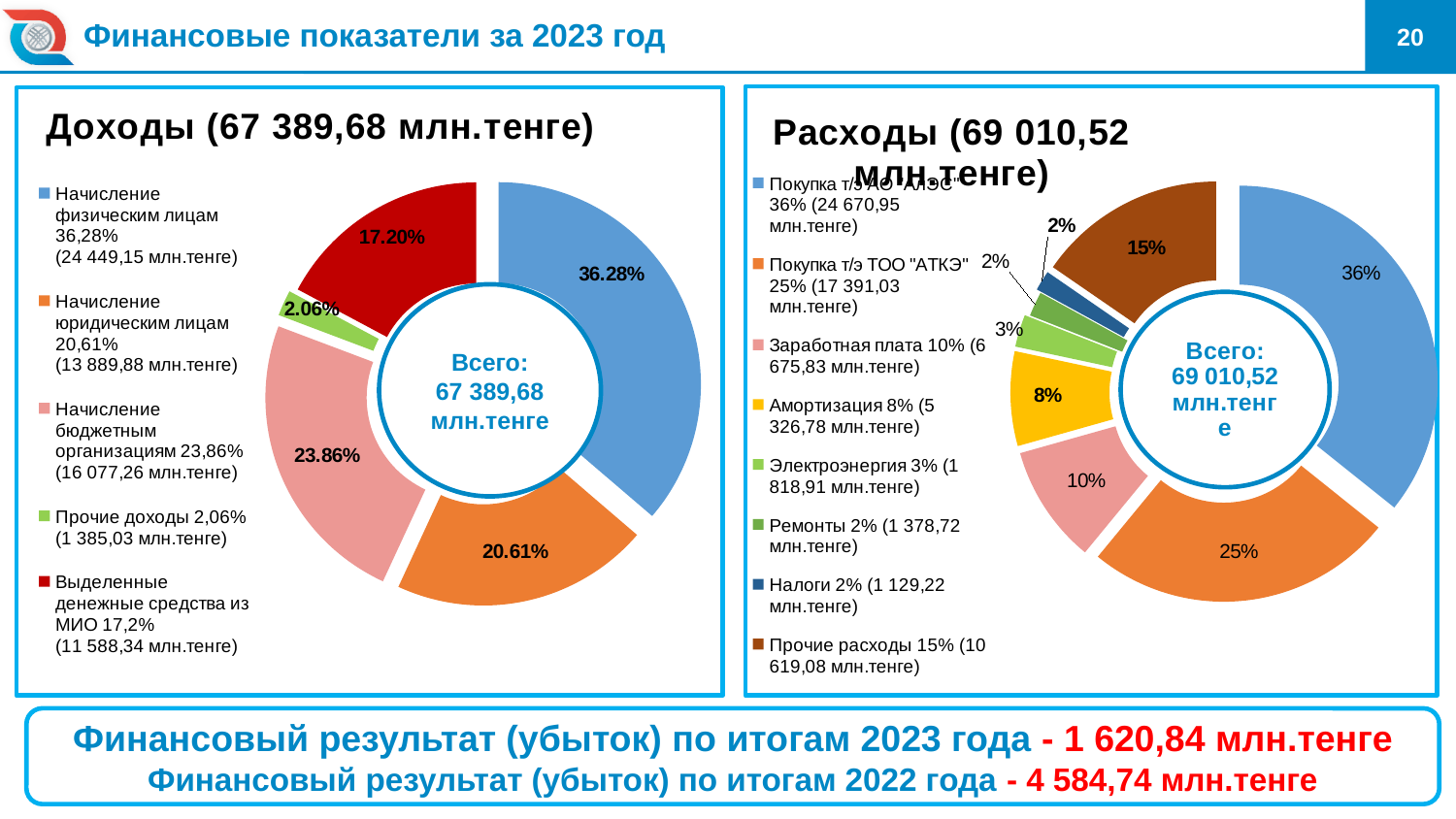
In the 'Расходы' chart, what amount in млн.тенге is given in the legend for 'Амортизация'? 5 326,78 млн.тенге In the 'Доходы' chart, what is the difference in percentage points between 'Начисление бюджетным организациям' (23.86%) and 'Начисление юридическим лицам' (20.61%)? 3.25 In the 'Доходы' chart, which category has the smallest share? Прочие доходы In the 'Расходы' chart, what percentage share is shown for 'Заработная плата'? 10% In the 'Расходы' chart, which category has the largest share? Покупка т/э АО "АлЭС" What type of chart is used on the 'Доходы (67 389,68 млн.тенге)' slide panel? Pie (doughnut) chart In the 'Расходы' chart, which share is larger: 'Прочие расходы' or 'Заработная плата'? Прочие расходы In the 'Доходы' chart, how many categories does the legend list? 5 In the 'Доходы' chart, what percentage share is shown for 'Начисление бюджетным организациям'? 23.86% In the 'Доходы' chart, which category has the largest share? Начисление физическим лицам In the 'Доходы' chart, what percentage share is shown for 'Начисление физическим лицам'? 36.28% In the 'Расходы' chart, how many categories does the legend list? 8